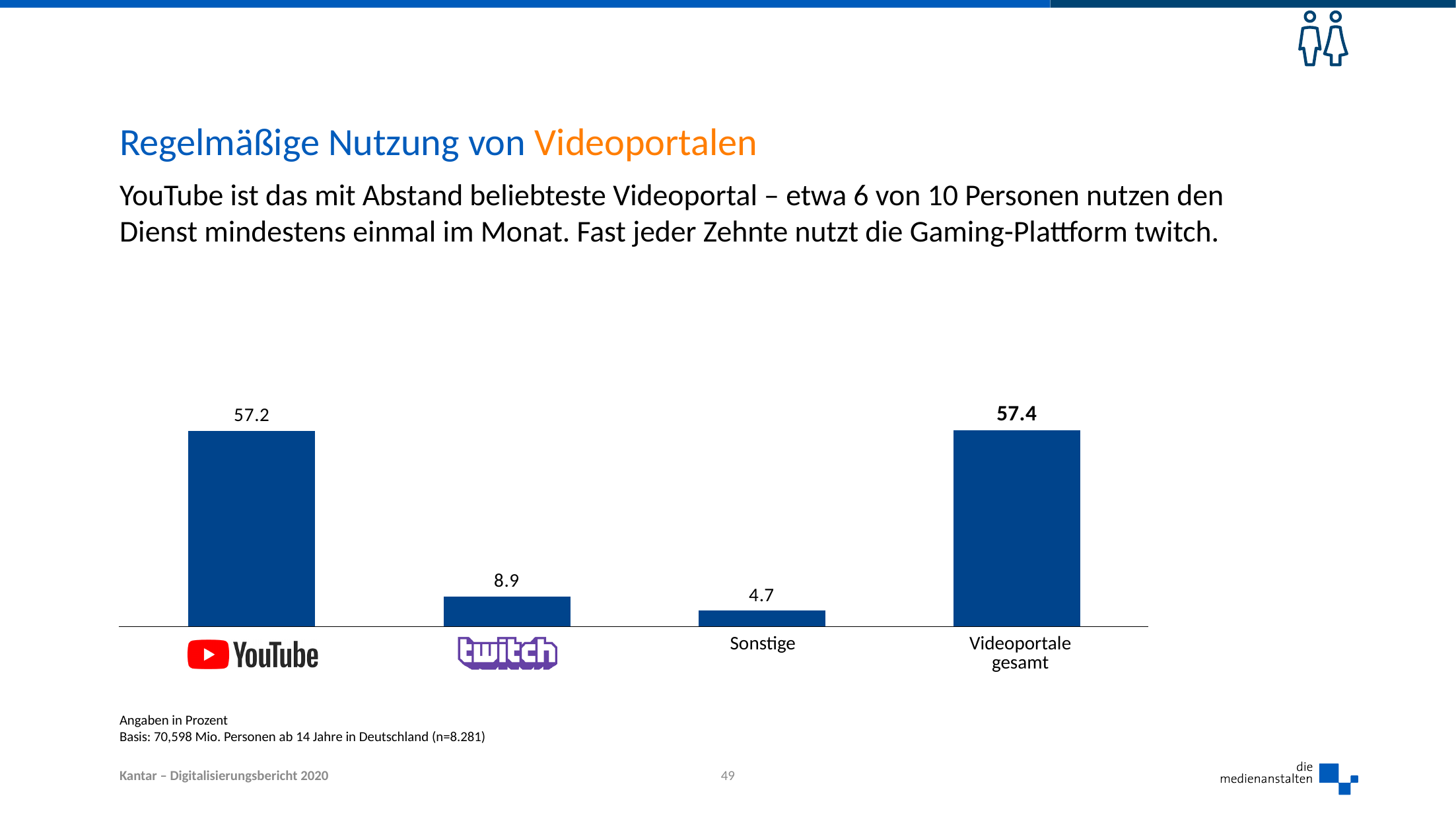
What is the difference between the values for YouTube and twitch? 48.3 In what unit are the values in the chart given, according to the note below it? Prozent What is the value for twitch? 8.9 What is the value for Videoportale gesamt? 57.4 What kind of chart is shown on the slide? bar chart Which category has the lowest value? Sonstige Which is larger, the value for twitch or the value for Sonstige? twitch Which category has the highest value? Videoportale gesamt How many categories are shown in the chart? 4 What is the value for YouTube? 57.2 What is the value for Sonstige? 4.7 What is the difference between the values for twitch and Sonstige? 4.2